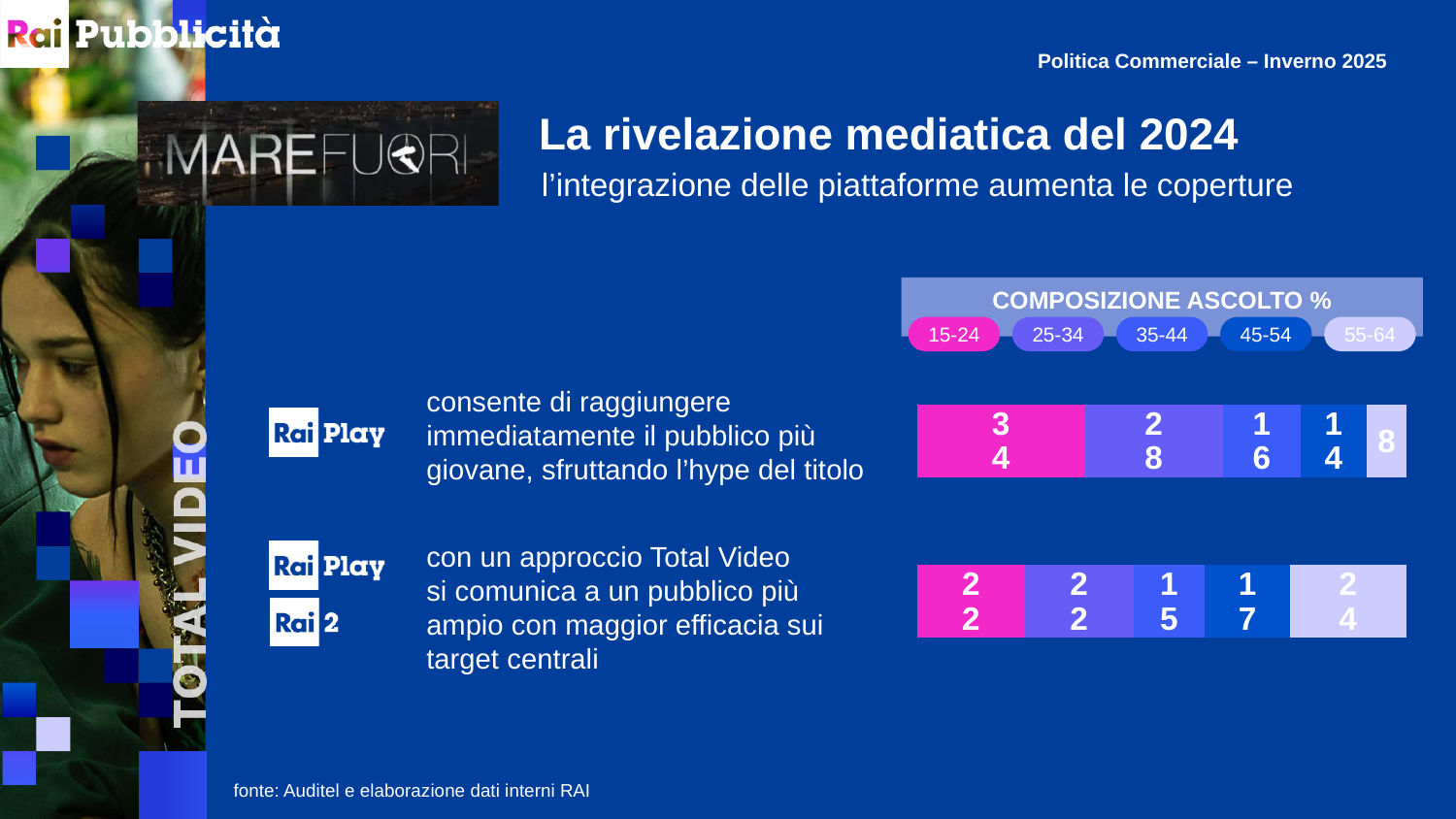
In the top bar (RaiPlay), what is the value for the 55-64 age group? 8 In the bottom bar (RaiPlay + Rai 2), which age group has the lowest share? 35-44 What is the title shown above the legend of the chart? COMPOSIZIONE ASCOLTO % What is the difference between the 15-24 value in the top bar (RaiPlay) and the 15-24 value in the bottom bar (RaiPlay + Rai 2)? 12 In the bottom bar (RaiPlay + Rai 2), what is the value for the 35-44 age group? 15 In the top bar (RaiPlay), which age group has the highest share? 15-24 In the bottom bar (RaiPlay + Rai 2), what is the value for the 55-64 age group? 24 How many age groups does the legend list? 5 Which is larger: the 45-54 value in the top bar (RaiPlay) or the 45-54 value in the bottom bar (RaiPlay + Rai 2)? bottom bar (RaiPlay + Rai 2) In the top bar (RaiPlay), which age group has the lowest share? 55-64 What kind of chart is shown on the slide? stacked bar chart In the top bar (RaiPlay), what is the value for the 15-24 age group? 34